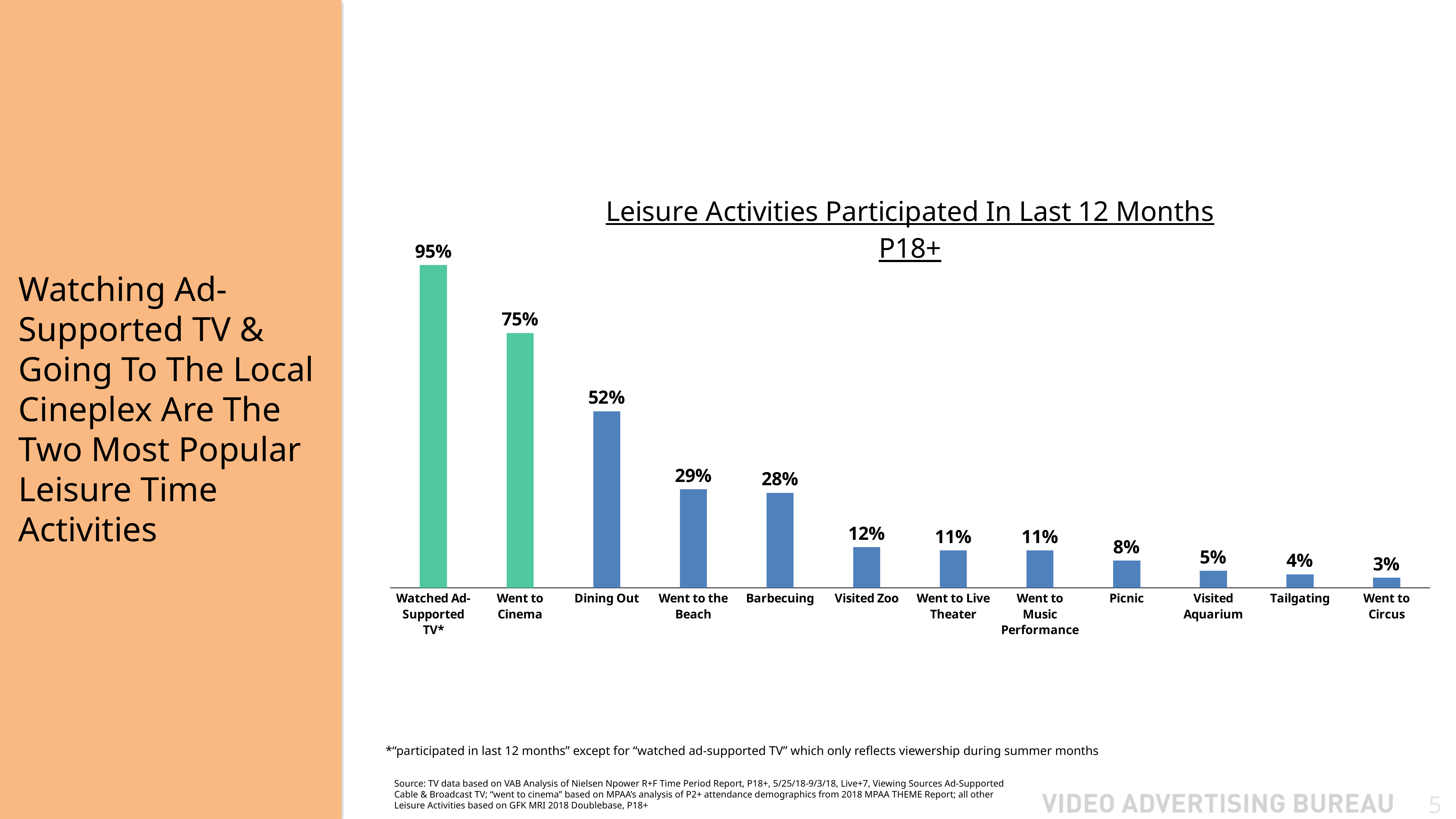
What is the value for Went to Cinema? 75% What is the difference between Went to the Beach and Barbecuing? 1% What kind of chart is shown on the slide? Bar chart What is the title of the chart? Leisure Activities Participated In Last 12 Months P18+ Which leisure activity has the lowest participation? Went to Circus What is the value for Visited Aquarium? 5% What percentage of P18+ watched ad-supported TV? 95% How many leisure activities are shown in the chart? 12 What is the difference between Watched Ad-Supported TV and Went to Cinema? 20% Which leisure activity has the highest participation? Watched Ad-Supported TV* Which is larger, Visited Zoo or Picnic? Visited Zoo What percentage participated in Dining Out? 52%